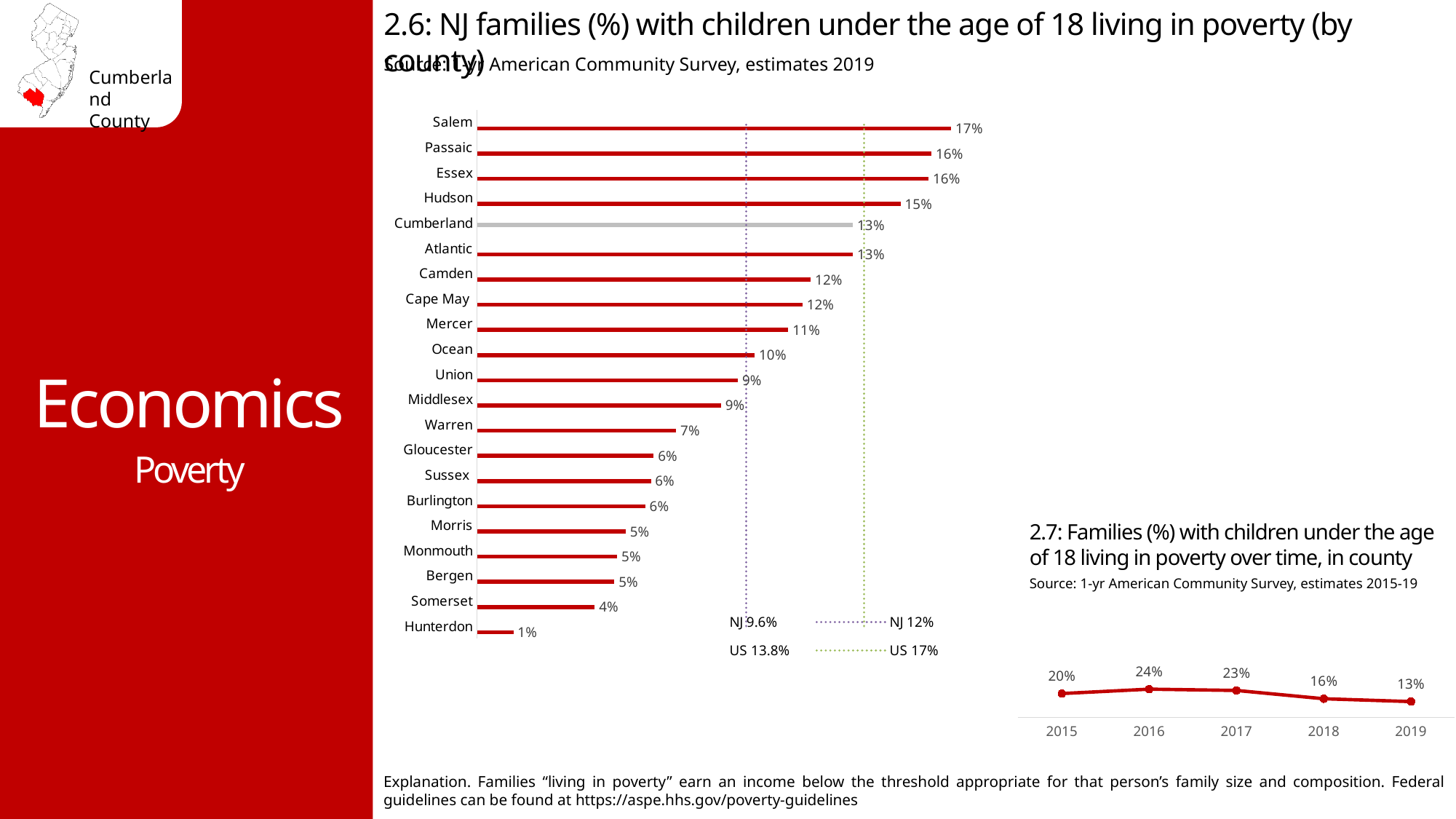
In chart 2.6, which county has the lowest value? Hunterdon In chart 2.6, which county has the highest value? Salem In chart 2.6, which is larger, the value for Camden or the value for Warren? Camden In chart 2.7, do the values rise or fall from 2017 to 2019? Fall In chart 2.7, what is the value for 2016? 24% In chart 2.6, what is the value for Hudson? 15% What kind of chart is chart 2.6? Bar chart In chart 2.6, what NJ value is shown by the dotted reference line labelled NJ? 9.6% In chart 2.6, how many counties are shown? 21 In chart 2.7, which year has the lowest value? 2019 In chart 2.6, what is the difference between Salem and Hunterdon? 16% In chart 2.6, what is the value for Cumberland? 13%